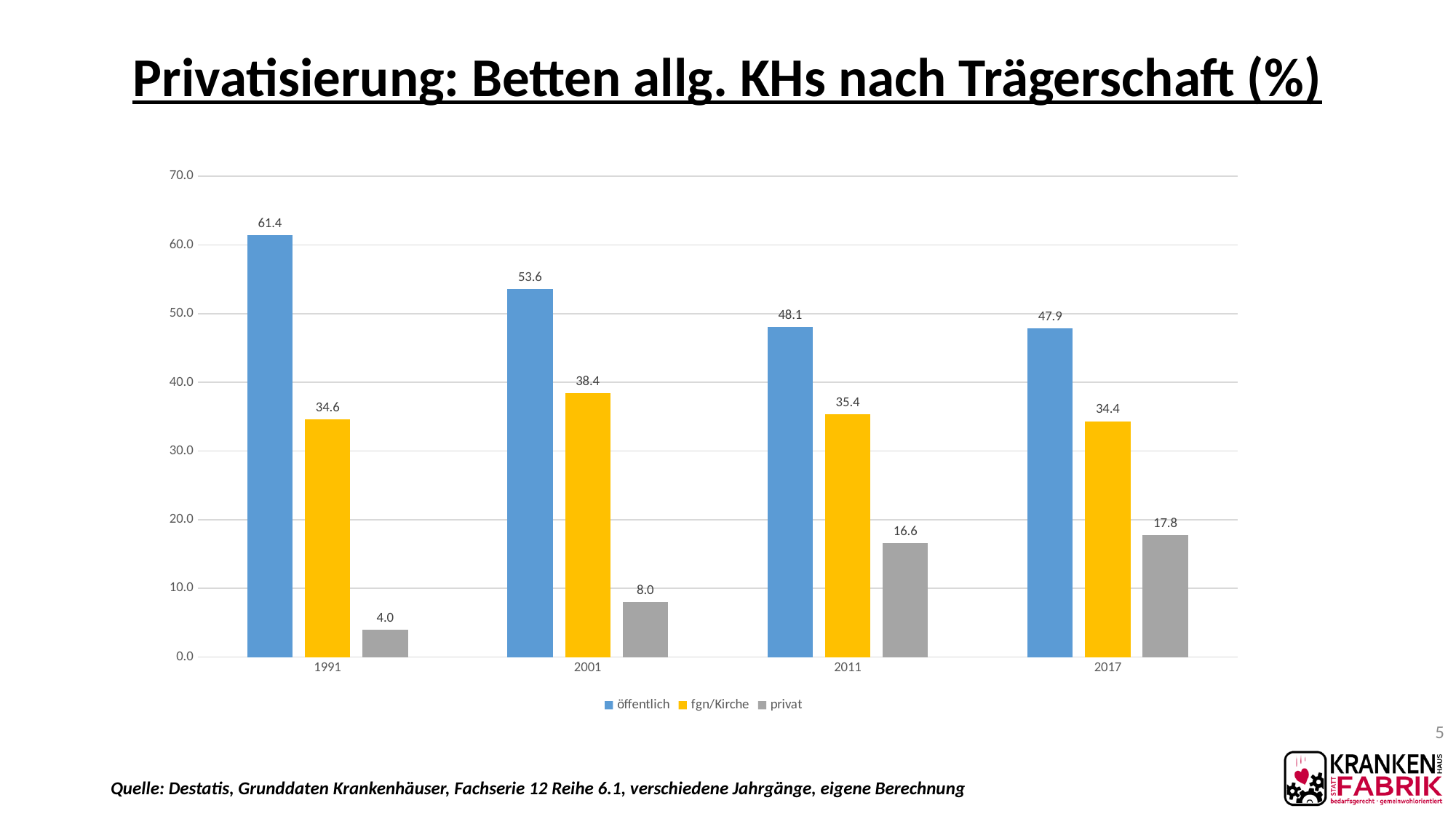
In which year is the öffentlich value lowest? 2017 Which colour represents the privat series? grey How many years are shown on the x axis? 4 How many series does the legend list? 3 In which year is the privat value highest? 2017 Which is larger, the fgn/Kirche value in 2001 or in 2017? 2001 What kind of chart is shown on the slide? bar chart What is the value for öffentlich in 1991? 61.4 What is the difference between the öffentlich values for 1991 and 2017? 13.5 What is the value for fgn/Kirche in 2001? 38.4 Do the öffentlich values rise or fall from 1991 to 2017? fall What is the value for privat in 2011? 16.6